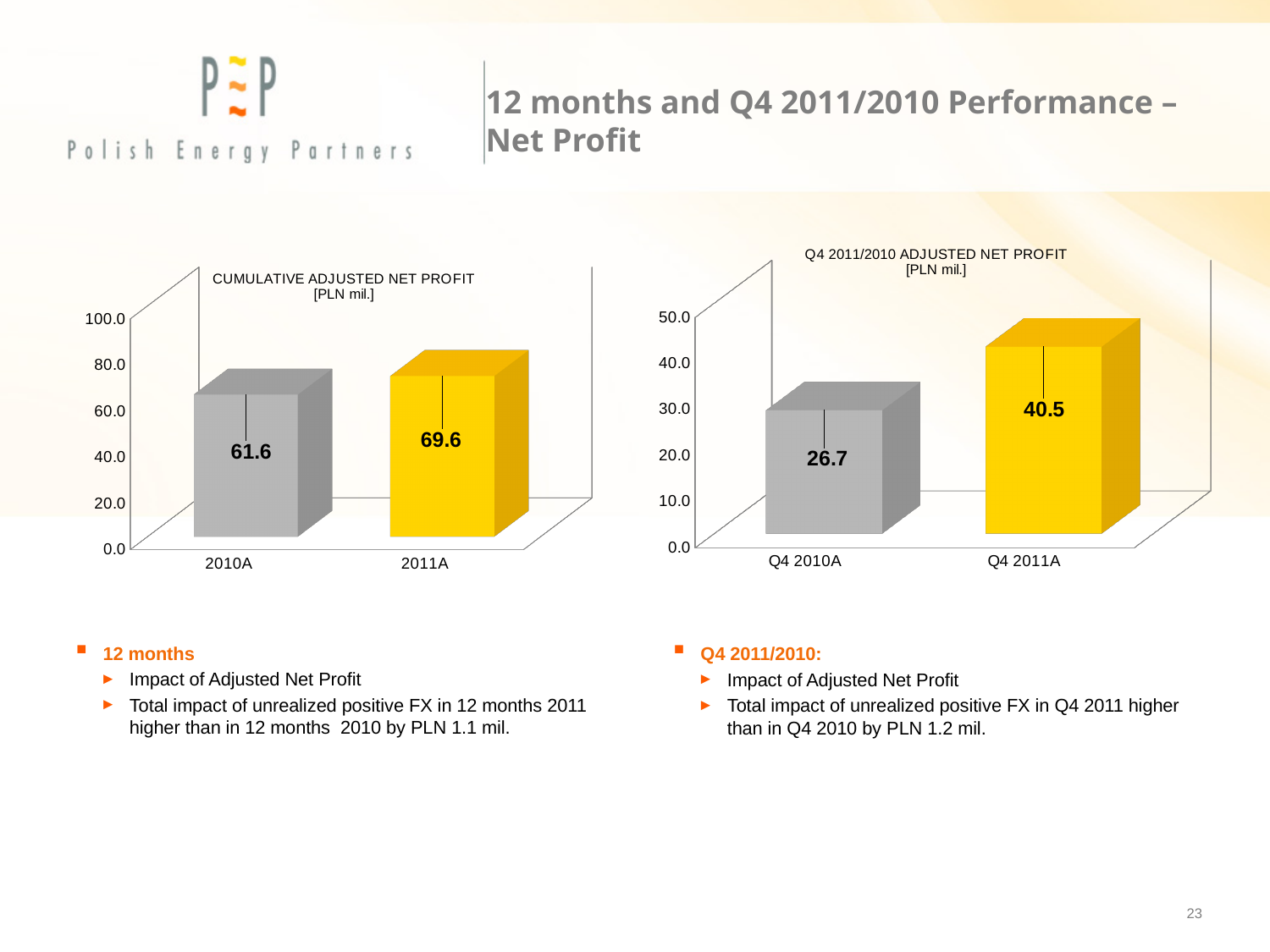
In the Q4 2011/2010 ADJUSTED NET PROFIT chart, is the value for Q4 2011A greater or less than 30.0? greater In what unit are the values in the CUMULATIVE ADJUSTED NET PROFIT chart expressed? PLN mil. In the CUMULATIVE ADJUSTED NET PROFIT chart, what is the value for 2010A? 61.6 How many bars are shown in the CUMULATIVE ADJUSTED NET PROFIT chart? 2 In the Q4 2011/2010 ADJUSTED NET PROFIT chart, what is the value for Q4 2010A? 26.7 What type of chart is the Q4 2011/2010 ADJUSTED NET PROFIT chart? Bar chart In the CUMULATIVE ADJUSTED NET PROFIT chart, which year has the higher value? 2011A In the Q4 2011/2010 ADJUSTED NET PROFIT chart, what is the value for Q4 2011A? 40.5 In the CUMULATIVE ADJUSTED NET PROFIT chart, what is the difference between the 2011A and 2010A values? 8.0 In the Q4 2011/2010 ADJUSTED NET PROFIT chart, which quarter has the lower value? Q4 2010A In the CUMULATIVE ADJUSTED NET PROFIT chart, what is the value for 2011A? 69.6 In the Q4 2011/2010 ADJUSTED NET PROFIT chart, what is the difference between the Q4 2011A and Q4 2010A values? 13.8